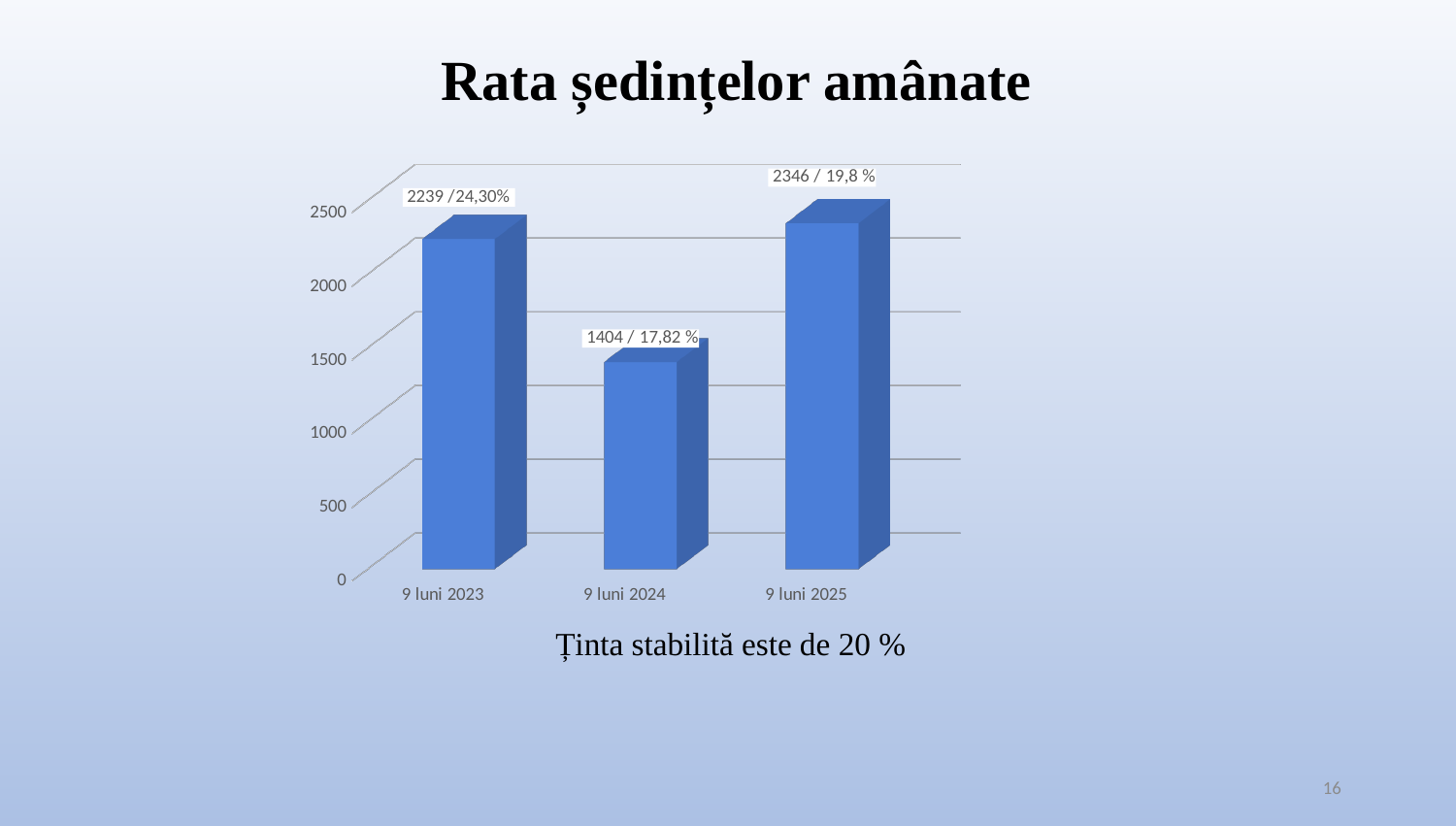
What kind of chart is shown on the slide? bar chart What is the title of the chart on the slide? Rata ședințelor amânate How many categories are shown on the x axis? 3 Which category has the lowest bar? 9 luni 2024 Is the value for 9 luni 2024 greater or less than 1500? less What data label is shown above the bar for 9 luni 2024? 1404 / 17,82 % Which is larger, the count for 9 luni 2023 or the count for 9 luni 2024? 9 luni 2023 What percentage is shown in the data label for 9 luni 2023? 24,30% What data label is shown above the bar for 9 luni 2025? 2346 / 19,8 % Which category has the highest bar? 9 luni 2025 What is the difference between the count for 9 luni 2023 (2239) and the count for 9 luni 2024 (1404)? 835 What is the difference between the count for 9 luni 2025 (2346) and the count for 9 luni 2023 (2239)? 107